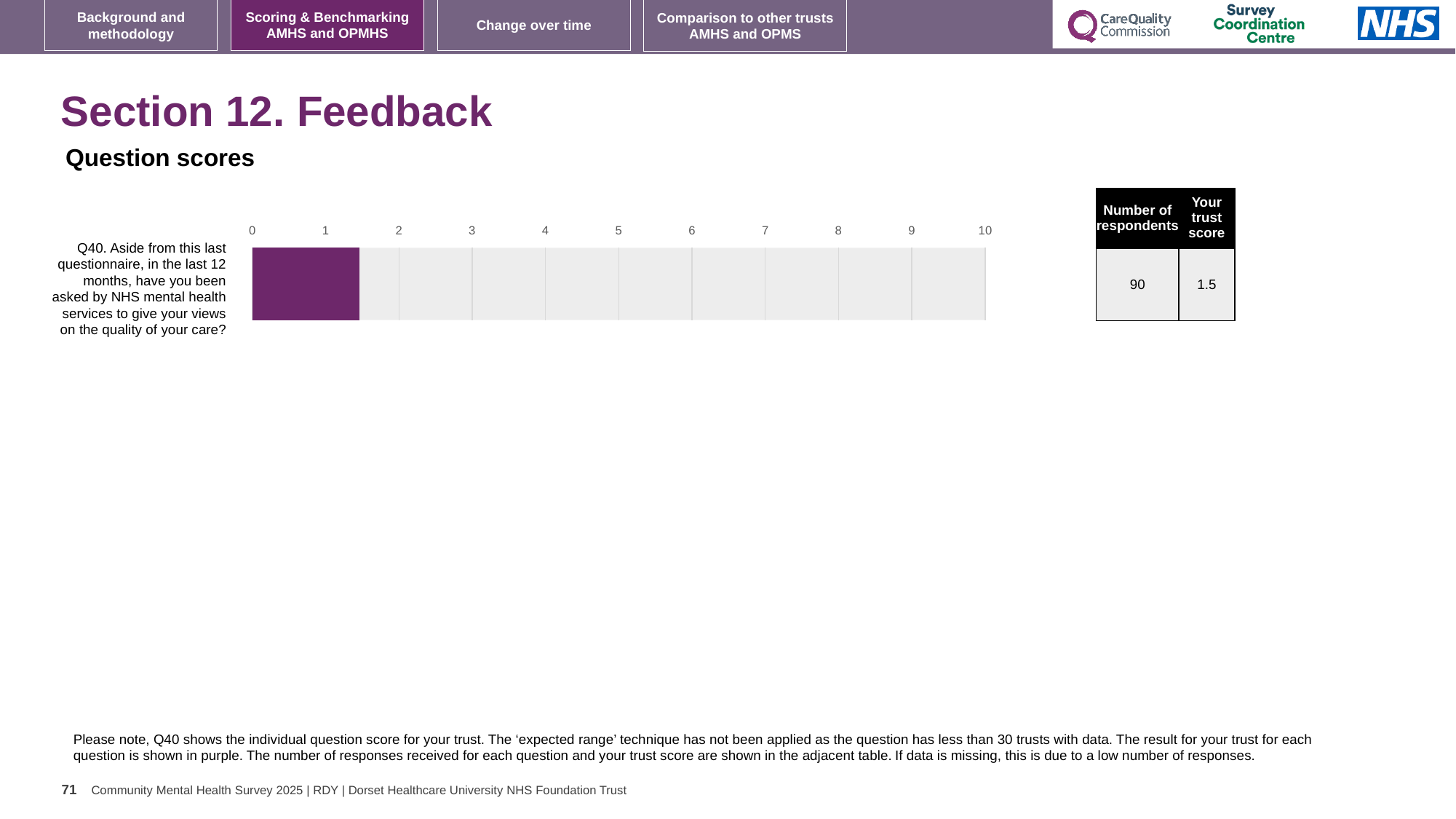
How many respondents answered Q40 according to the table? 90 Is the value for Q40 greater or less than 5? less Is the value for Q40 greater or less than 1? greater What colour is the bar showing the trust's result for Q40? Purple What is the maximum value shown on the chart's axis? 10 What kind of chart is shown on the slide? Bar chart Is the value for Q40 greater or less than 2? less How many questions (categories) are plotted in the chart? 1 What is the trust score for Q40 shown on the slide? 1.5